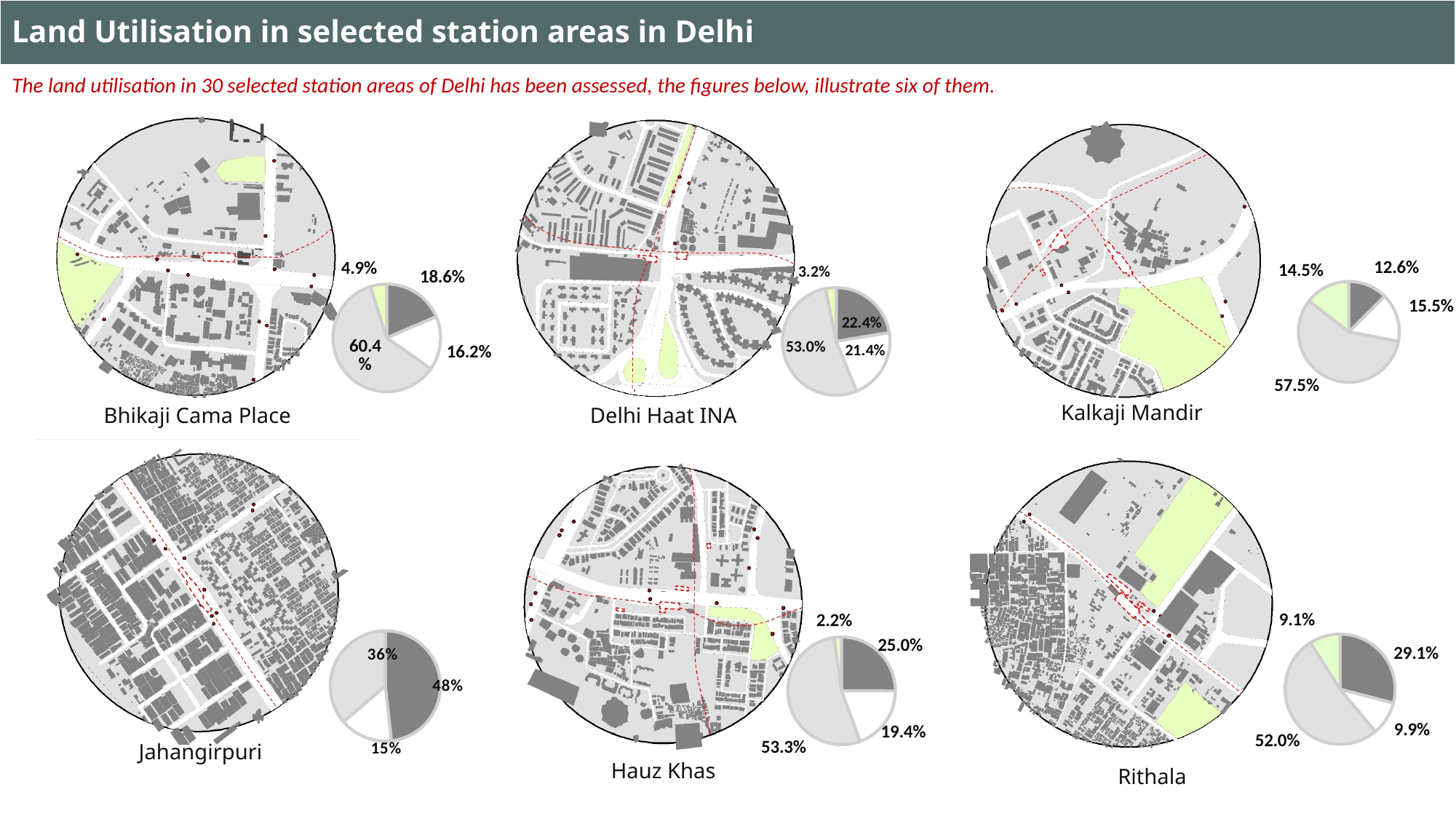
In the Jahangirpuri pie chart, what is the value of the dark grey slice? 48% Which is larger: the dark grey slice in the Rithala pie chart or the dark grey slice in the Hauz Khas pie chart? Rithala In the Delhi Haat INA pie chart, what is the value of the dark grey slice? 22.4% In the Delhi Haat INA pie chart, what is the difference between the largest slice (53.0%) and the dark grey slice (22.4%)? 30.6% How many slices does the Jahangirpuri pie chart have? 3 In the Bhikaji Cama Place pie chart, what is the value of the largest slice? 60.4% What type of charts are used to show land utilisation for each station area? Pie charts In the Rithala pie chart, what is the value of the dark grey slice? 29.1% In the Hauz Khas pie chart, what is the value of the smallest slice? 2.2% In the Bhikaji Cama Place pie chart, what is the value of the smallest slice? 4.9% In the Kalkaji Mandir pie chart, what is the value of the light green slice? 14.5% In the Kalkaji Mandir pie chart, what is the value of the smallest slice? 12.6%